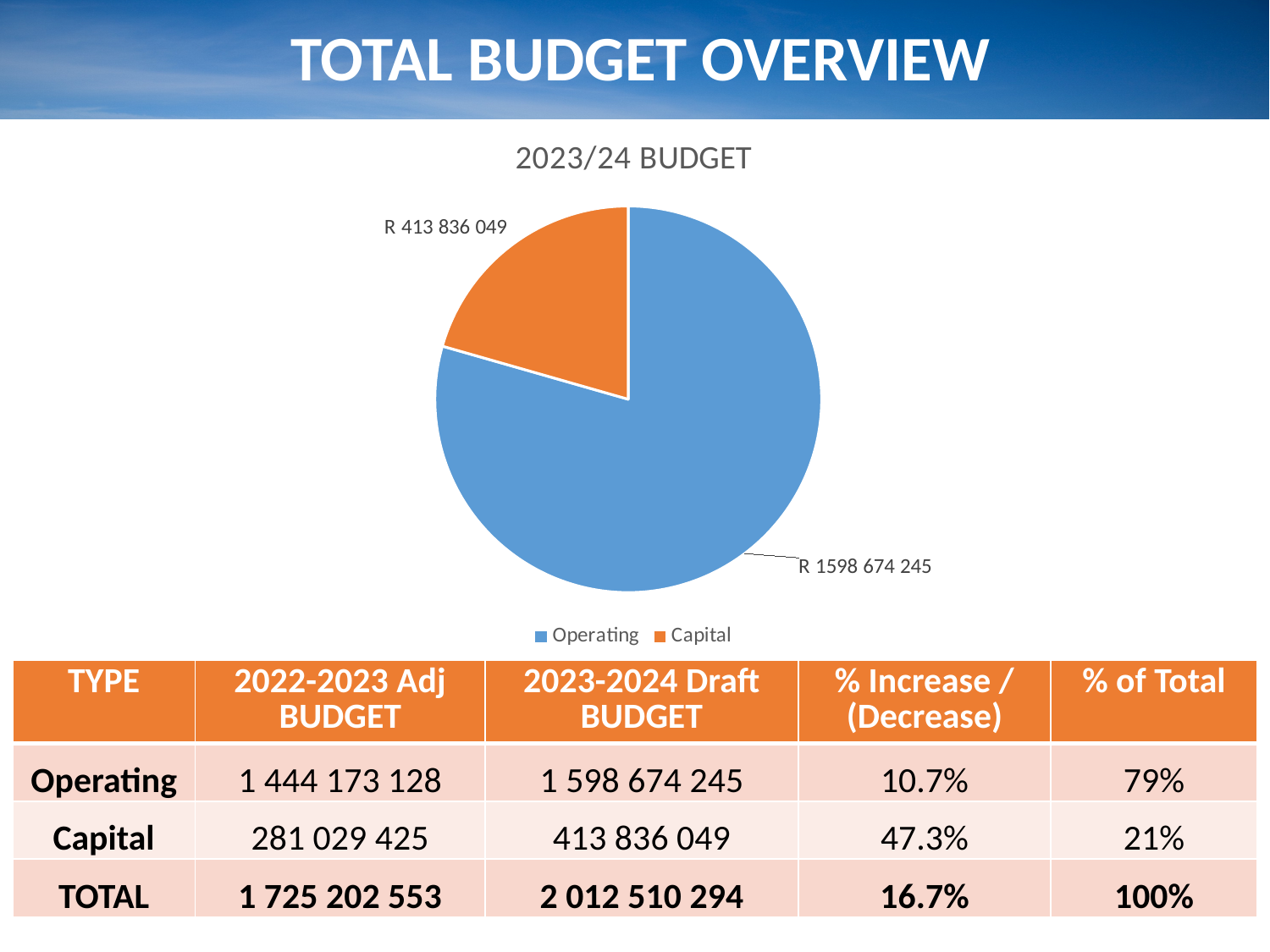
What is the title of the chart? 2023/24 BUDGET Which slice of the pie chart is the largest? Operating What is the total of the two slices in the pie chart? R 2 012 510 294 What colour is the Capital slice in the pie chart? orange How many slices does the pie chart have? 2 How many entries does the chart legend list? 2 What is the value of the Operating slice in the pie chart? R 1598 674 245 Which slice of the pie chart is the smallest? Capital What is the difference between the Operating and Capital values in the pie chart? R 1 184 838 196 What is the value of the Capital slice in the pie chart? R 413 836 049 What type of chart is shown on the slide? pie chart Which is larger in the pie chart, Operating or Capital? Operating